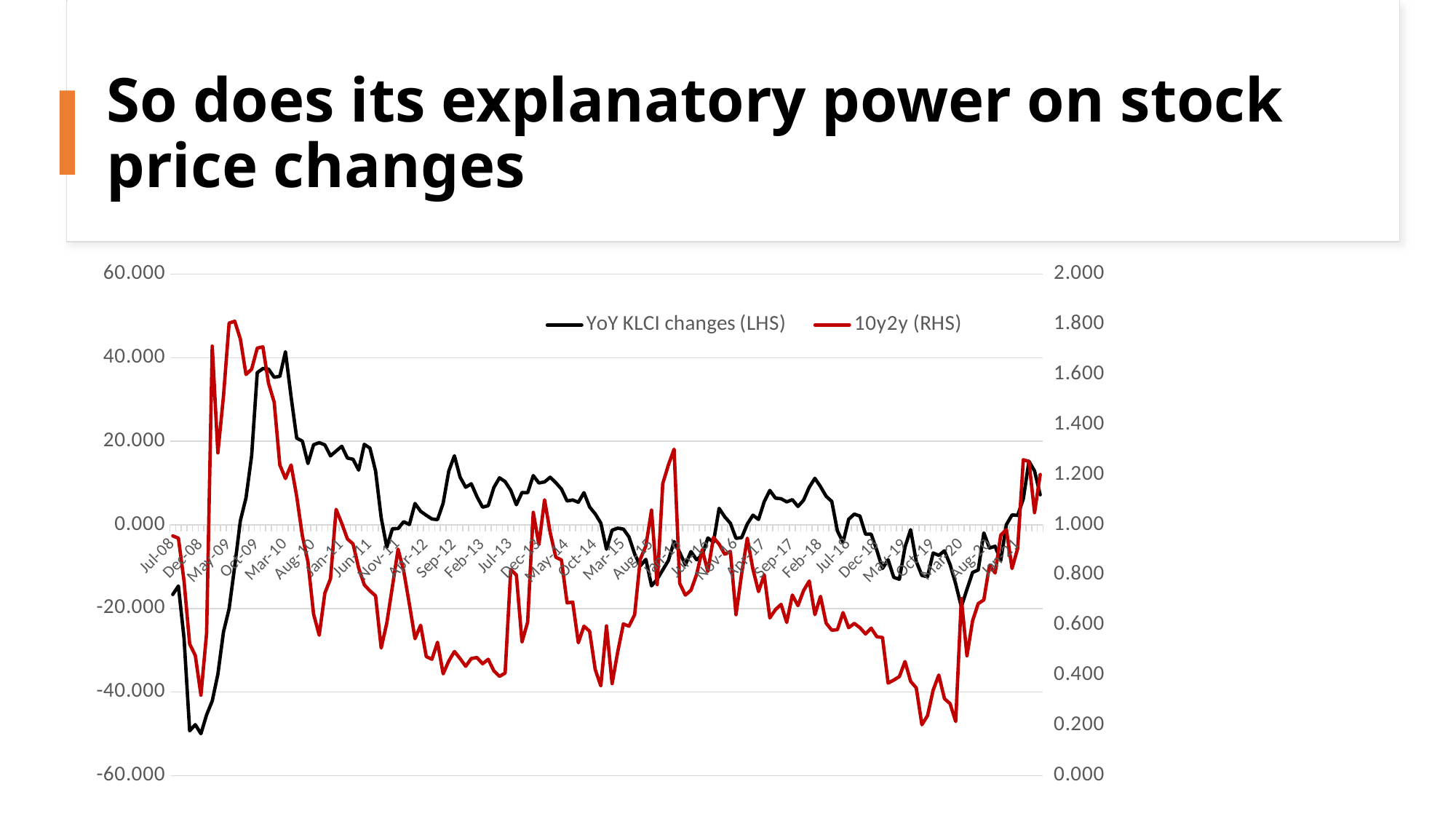
Does the 10y2y (RHS) line rise or fall between Feb-18 and Oct-19? fall Is the value for 10y2y (RHS) at Oct-19 greater or less than 0.400? less Is the lowest value of YoY KLCI changes (LHS), reached in early 2009, greater or less than -40.000? less Which series is plotted in red? 10y2y (RHS) Does the 10y2y (RHS) line rise or fall between Mar-20 and Jan-21? rise Is the value for YoY KLCI changes (LHS) at Jul-08 greater or less than 0.000? less What kind of chart is shown on the slide? line chart How many series does the chart legend list? 2 What is the maximum value shown on the right-hand vertical axis? 2.000 Does the YoY KLCI changes (LHS) line rise or fall between Jul-08 and Dec-08? fall